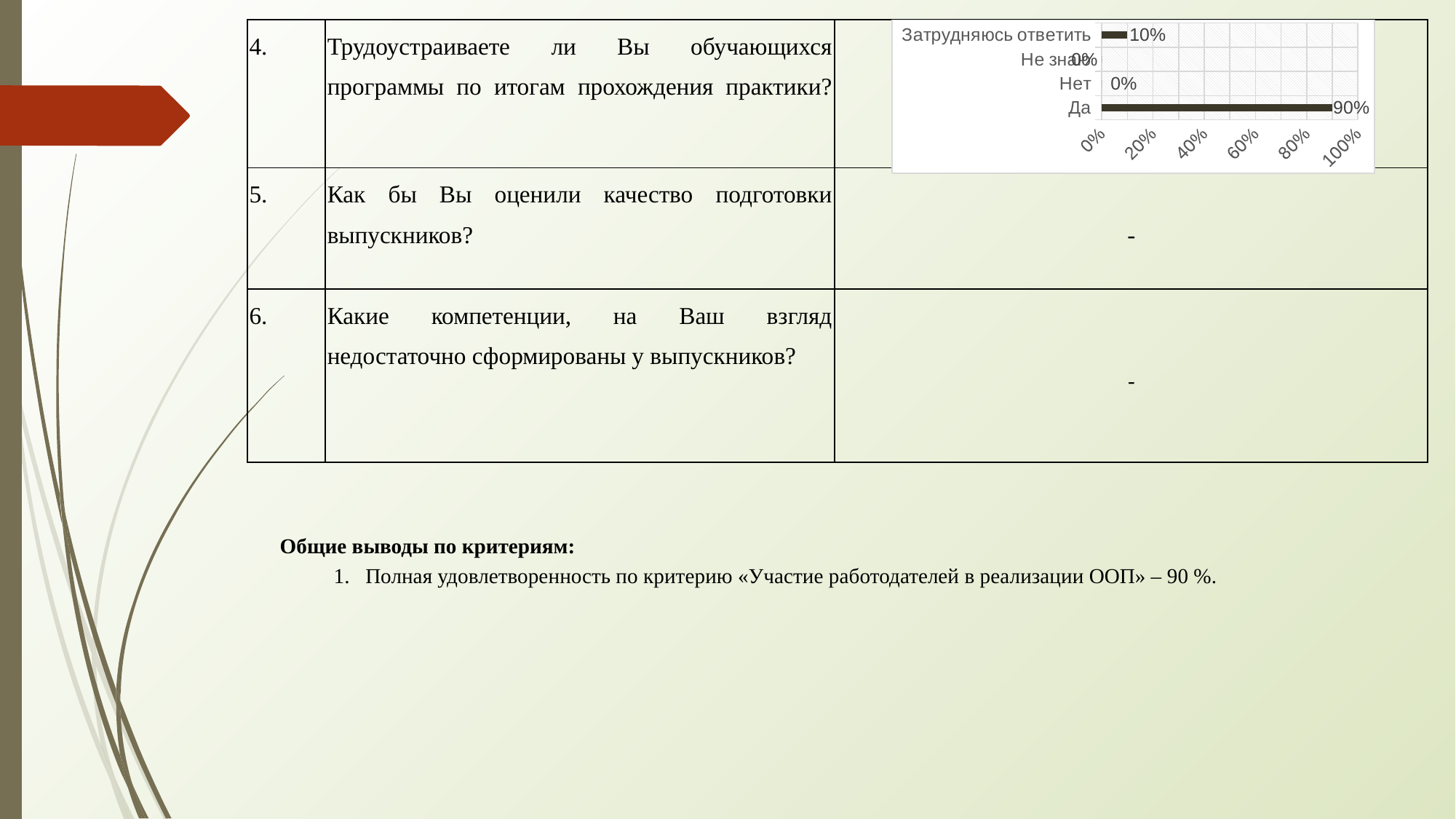
What is the value for "Затрудняюсь ответить" in the chart? 10% Is the value for "Да" greater or less than 80%? greater Which category has the highest value in the chart? Да What kind of chart is shown on the slide? bar chart Which is larger, the value for "Да" or the value for "Затрудняюсь ответить"? Да What is the highest tick label on the x axis of the chart? 100% What is the difference between the values for "Да" and "Затрудняюсь ответить"? 80% What is the value for "Да" in the chart? 90% What is the value for "Не знаю" in the chart? 0% Is the value for "Затрудняюсь ответить" greater or less than 20%? less What is the value for "Нет" in the chart? 0% How many categories are shown in the chart? 4